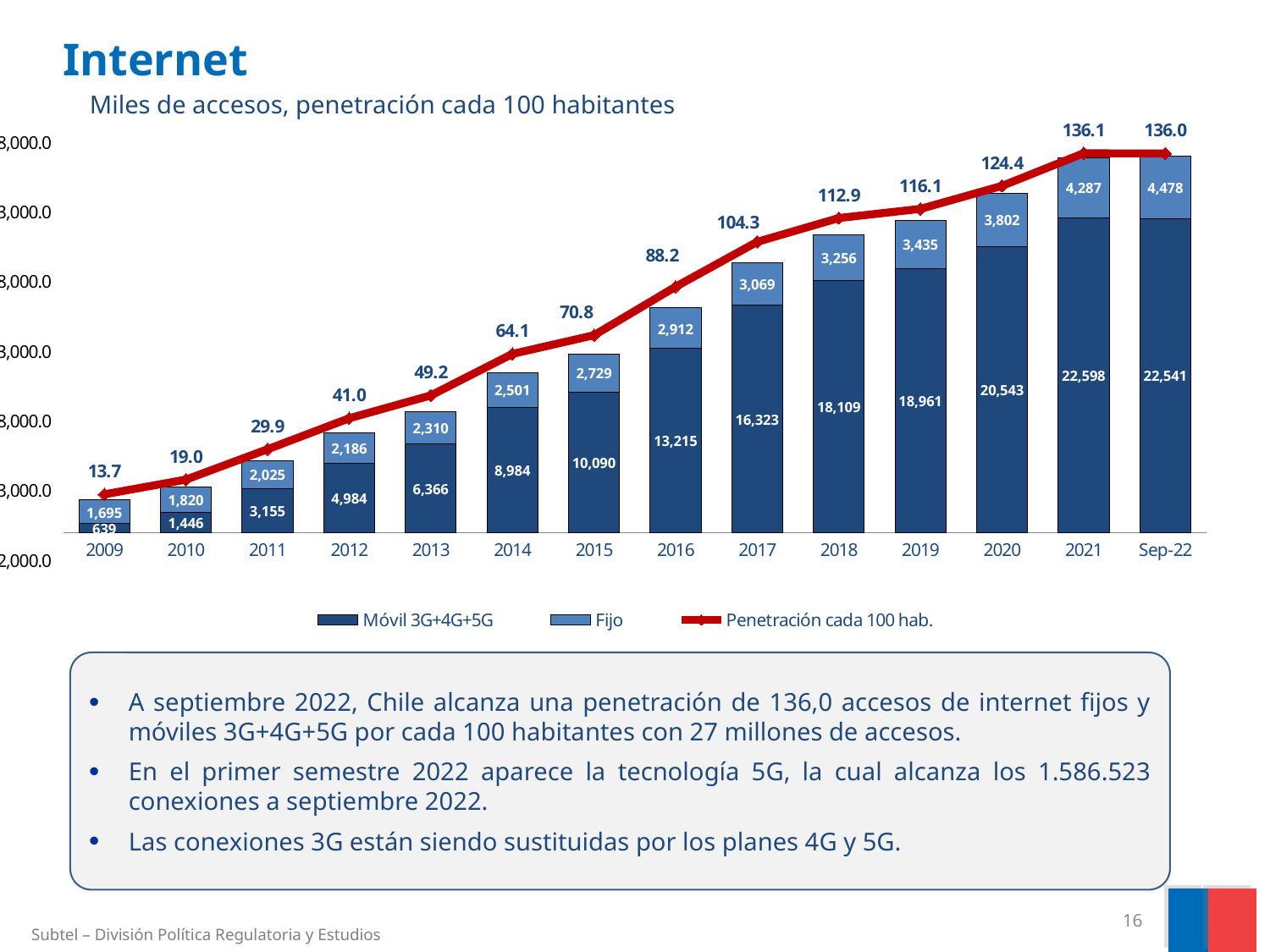
What is the difference between the Móvil 3G+4G+5G value in 2021 and in Sep-22? 57 In which year is the Penetración cada 100 hab. value highest? 2021 How many series does the legend list? 3 What is the Penetración cada 100 hab. value in 2014? 64.1 In which year is the Fijo value lowest? 2009 What is the total of the stacked bar (Móvil 3G+4G+5G plus Fijo) for 2017? 19,392 In 2012, which is larger: Móvil 3G+4G+5G or Fijo? Móvil 3G+4G+5G What is the value of Fijo in 2019? 3,435 Does the Fijo value rise or fall from 2009 to Sep-22? Rise What is the value of Móvil 3G+4G+5G in 2016? 13,215 How many time periods are shown on the x axis? 14 What kind of chart is this? Stacked bar chart with a line